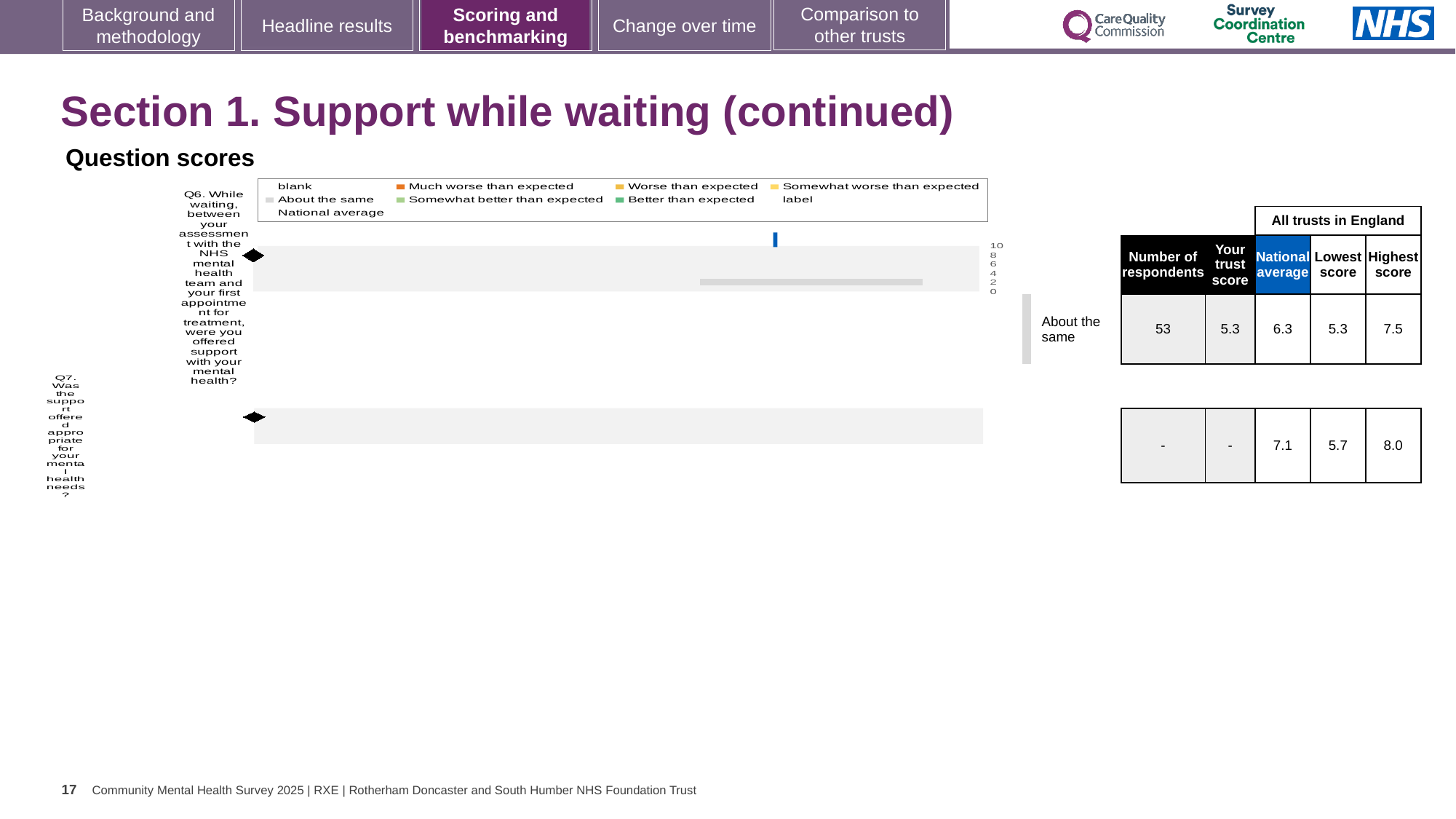
What is the highest value shown on the chart's score axis? 10 What is the difference between the national average and the trust score for Q6? 1.0 What is the highest score among all trusts in England for Q7? 8.0 How many respondents answered Q6? 53 What is the national average for Q6? 6.3 What kind of chart is shown under 'Question scores'? bar chart Which legend category does the Q6 bar belong to, according to the label beside the chart? About the same Is the trust score for Q6 greater or less than 6? less For Q6, which is larger: the trust score or the national average? national average What is the trust score for Q6? 5.3 How many questions (categories) are plotted on the chart? 2 What is the national average for Q7? 7.1